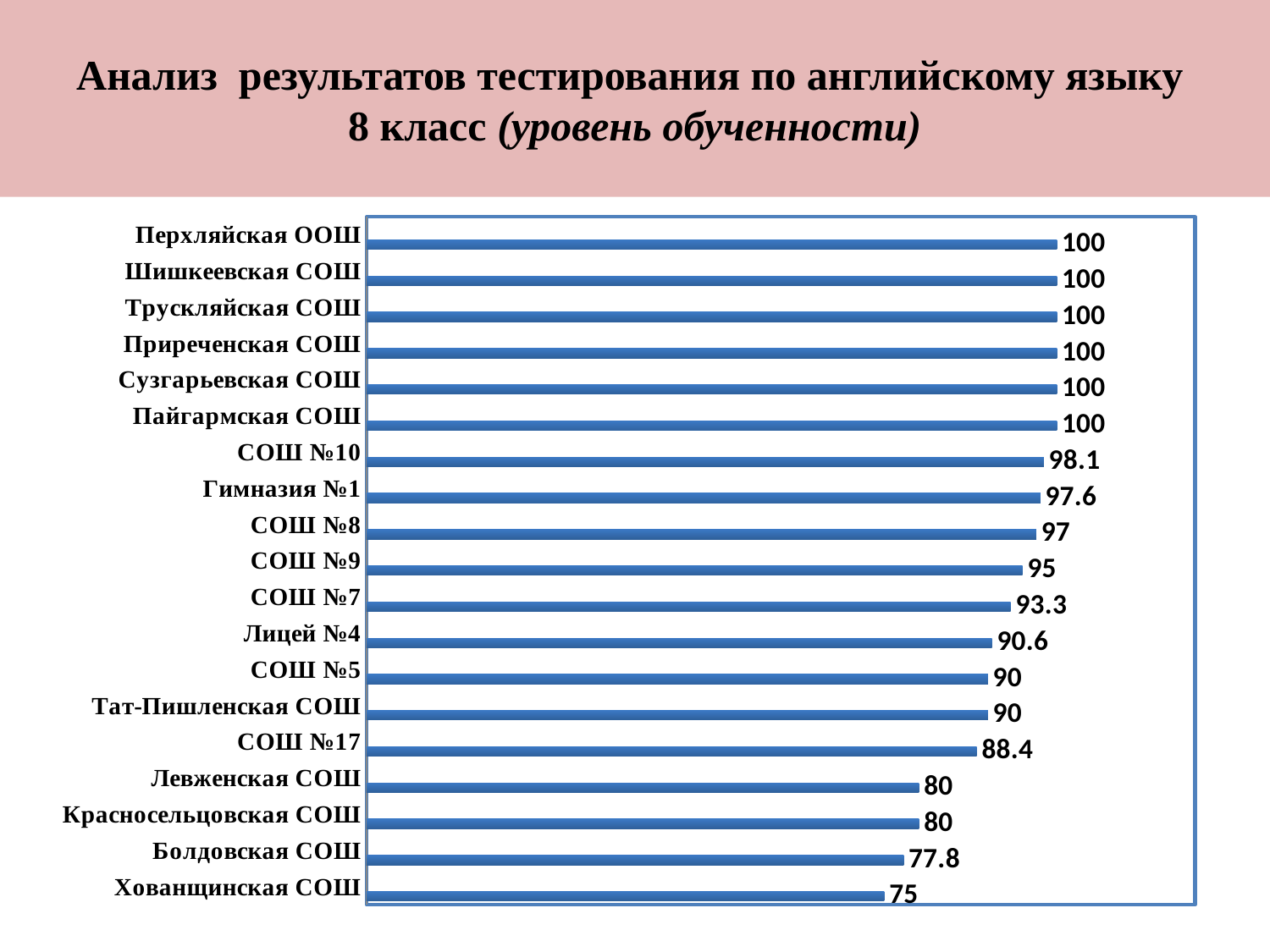
What is the difference between the values for СОШ №8 and СОШ №17? 8.6 Which is larger, the value for СОШ №7 or the value for СОШ №5? СОШ №7 How many schools are shown in the chart? 19 Which school has the lowest value? Хованщинская СОШ What is the value for Лицей №4? 90.6 What kind of chart is shown on the slide? Bar chart What is the value for СОШ №10? 98.1 How many schools have a value of 100? 6 What is the difference between the values for Перхляйская ООШ and Хованщинская СОШ? 25 What is the value for Болдовская СОШ? 77.8 What is the value for Гимназия №1? 97.6 Which is larger, the value for Левженская СОШ or the value for Болдовская СОШ? Левженская СОШ